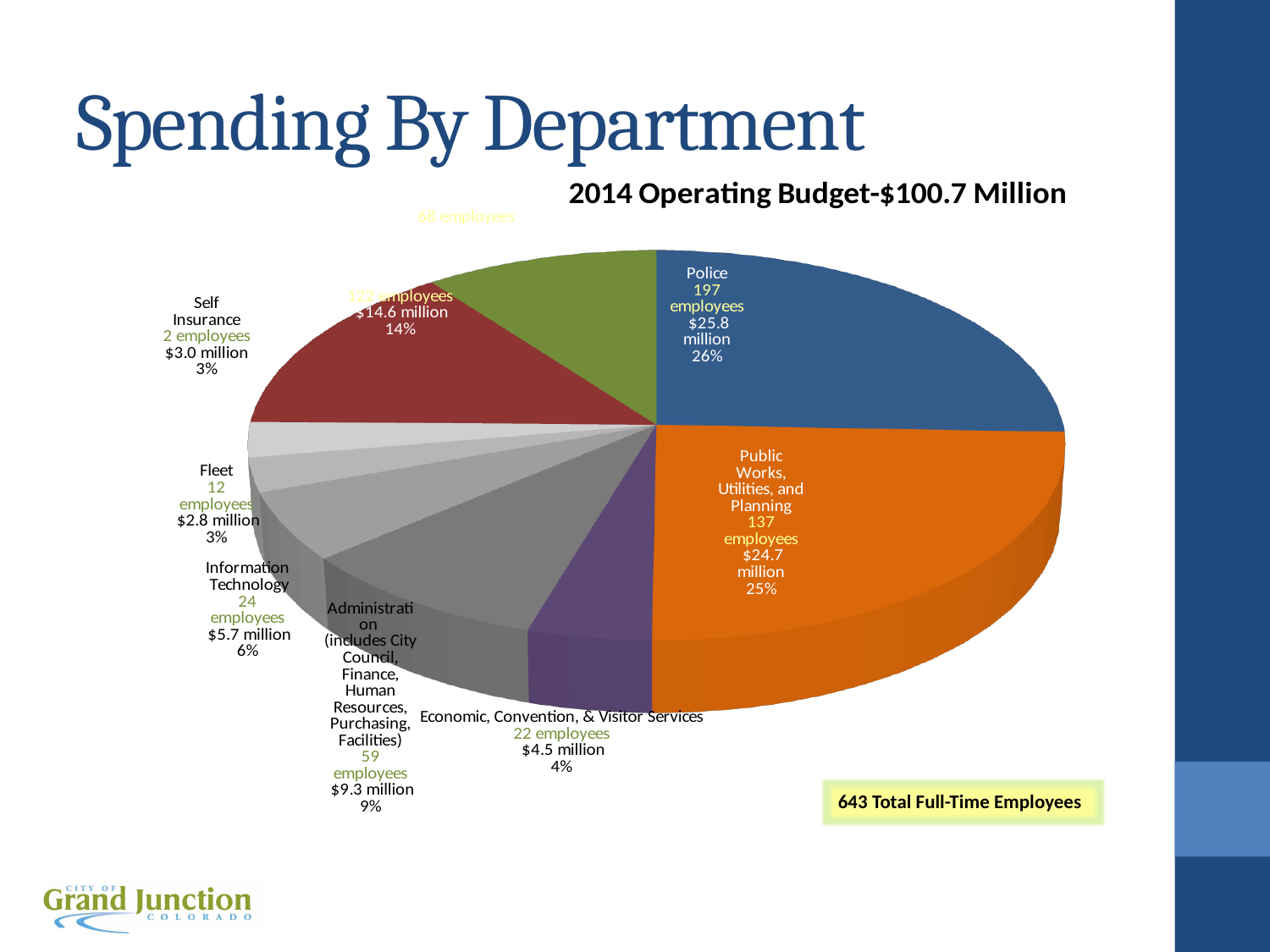
How much spending is shown for Fleet? $2.8 million Which has higher spending, Administration or Information Technology? Administration What share of the 2014 operating budget goes to Police? 26% Which labelled department has the largest share of the budget? Police What kind of chart is shown on the slide? pie chart According to the box on the slide, how many total full-time employees are there? 643 What is the title of the chart? 2014 Operating Budget-$100.7 Million How much spending is shown for Police? $25.8 million How many employees are listed for Public Works, Utilities, and Planning? 137 What percentage of the budget goes to Economic, Convention, & Visitor Services? 4% How many employees are listed for Self Insurance? 2 employees What is the difference in spending between Police and Public Works, Utilities, and Planning? $1.1 million